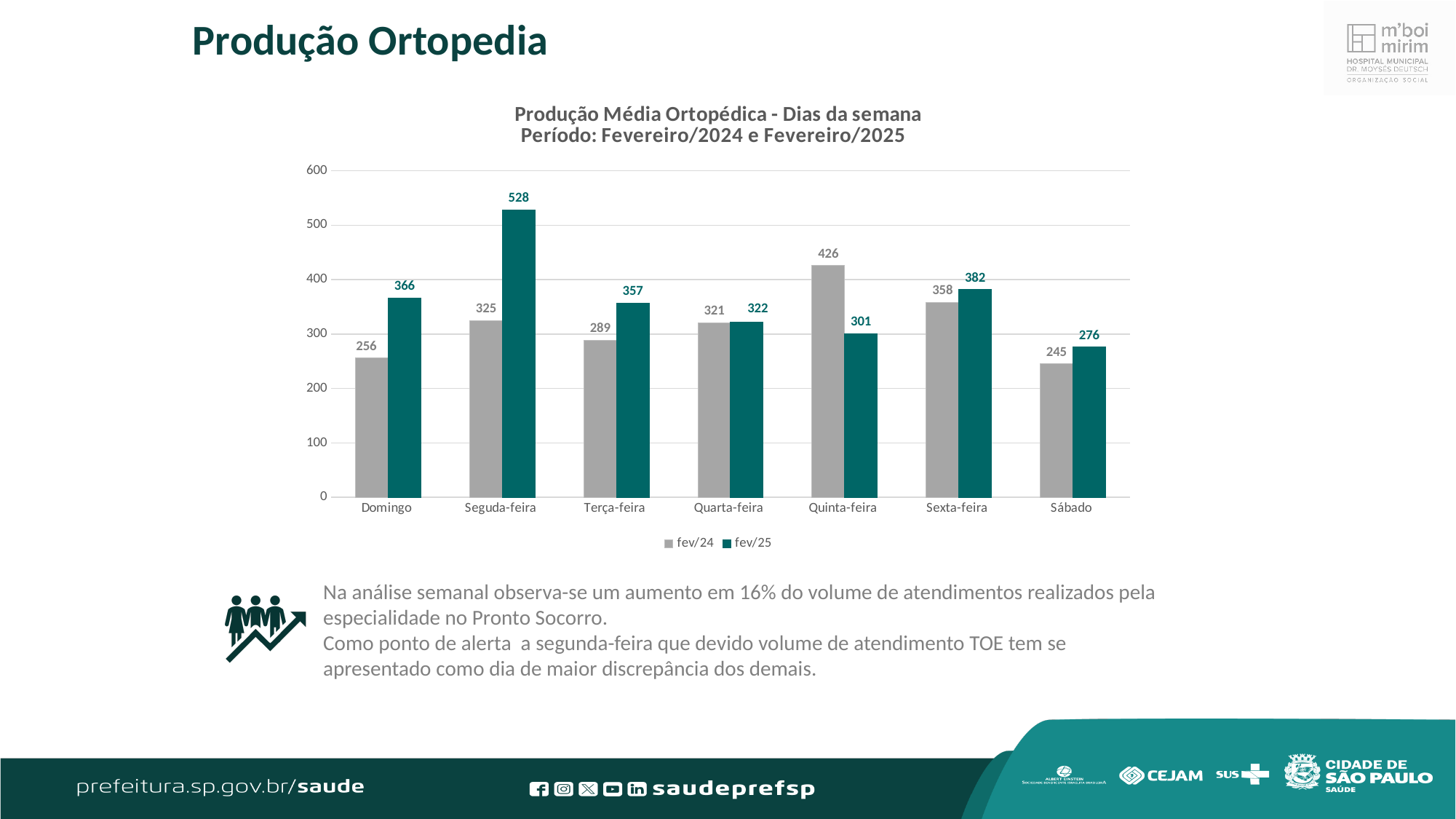
How many series does the legend list? 2 Which day has the lowest fev/24 value? Sábado What is the difference between the fev/25 and fev/24 values for Domingo? 110 What is the fev/25 value for Sábado? 276 What is the fev/25 value for Seguda-feira? 528 For Quinta-feira, which is larger: the fev/24 value or the fev/25 value? fev/24 How many days of the week are shown on the x axis? 7 Which day has the highest fev/25 value? Seguda-feira What is the fev/24 value for Quinta-feira? 426 Is the fev/24 value for Terça-feira greater or less than 300? less Which series is shown in grey in the legend? fev/24 What kind of chart is shown on the slide? bar chart